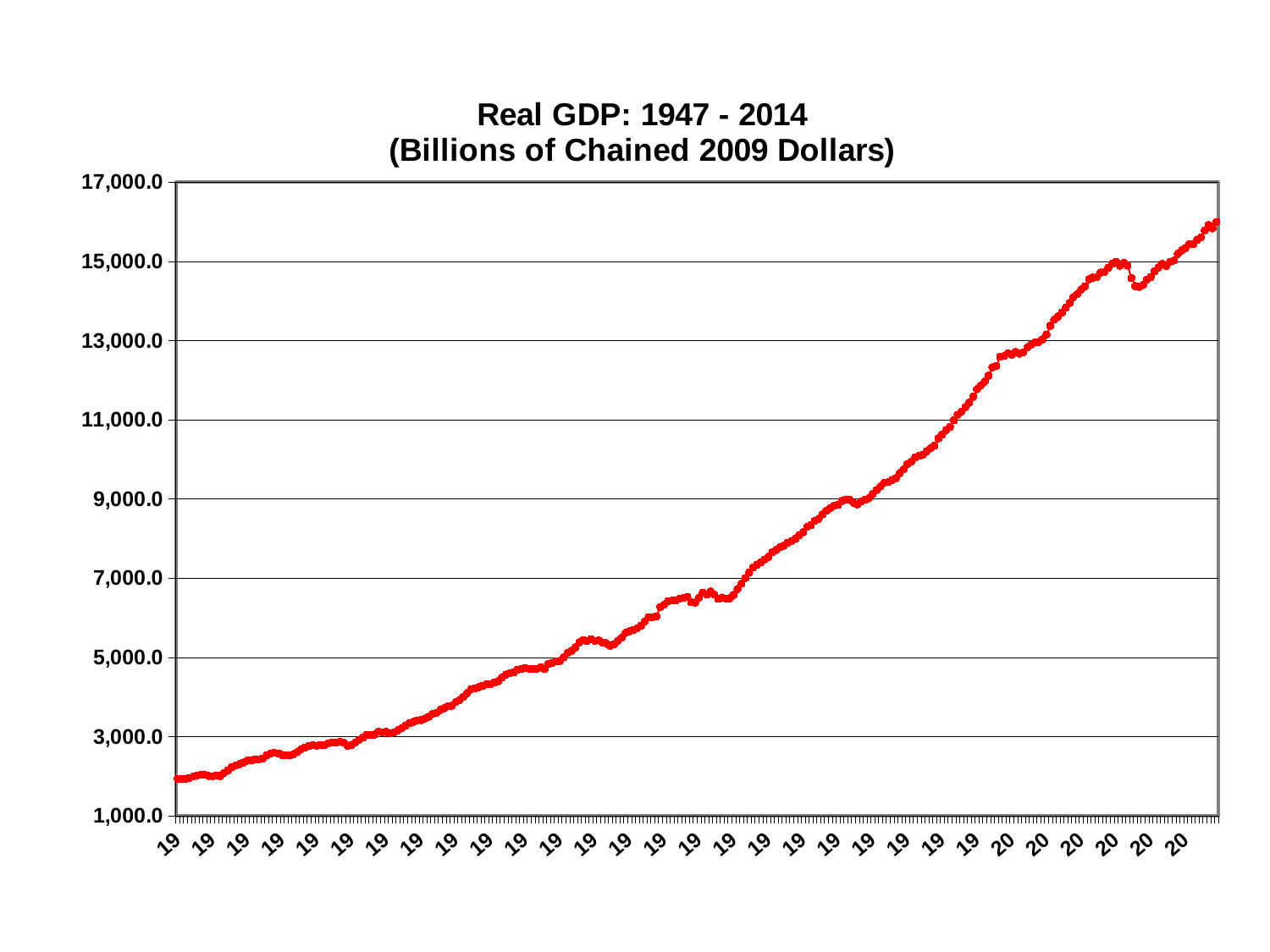
At which end of the period, 1947 or 2014, is Real GDP highest? 2014 Do the values of Real GDP generally rise or fall along the x axis from 1947 to 2014? rise What is the title of the chart? Real GDP: 1947 - 2014 (Billions of Chained 2009 Dollars) Is the value of Real GDP at the start of the series (1947) greater or less than 1,000.0? greater Is the value of Real GDP at the end of the series (2014) greater or less than 17,000.0? less Is the value of Real GDP at the start of the series (1947) greater or less than 3,000.0? less At which end of the period, 1947 or 2014, is Real GDP lowest? 1947 Which is larger, Real GDP at the start of the series (1947) or at the end of the series (2014)? 2014 What kind of chart is shown on the slide? line chart In what units is Real GDP measured on the chart? Billions of Chained 2009 Dollars